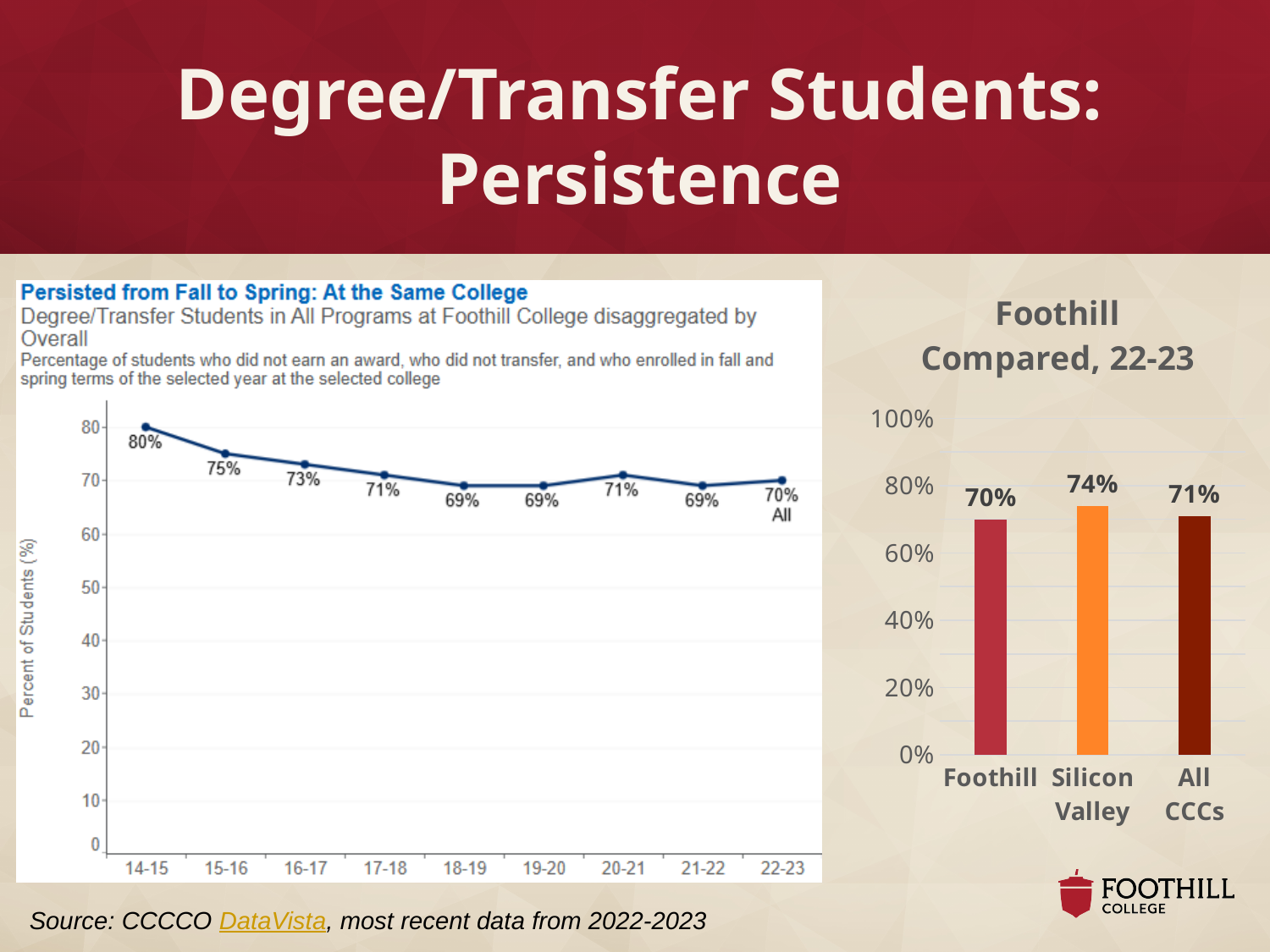
In the 'Foothill Compared, 22-23' chart, what is the value for Silicon Valley? 74% In the line chart 'Persisted from Fall to Spring: At the Same College', do the values generally rise or fall from 14-15 to 18-19? fall In the 'Foothill Compared, 22-23' chart, which category has the lowest value? Foothill What kind of chart is the 'Foothill Compared, 22-23' chart? bar chart In the line chart 'Persisted from Fall to Spring: At the Same College', what is the difference between the values for 14-15 and 22-23? 10 percentage points In the line chart 'Persisted from Fall to Spring: At the Same College', what is the value for 14-15? 80% In the line chart 'Persisted from Fall to Spring: At the Same College', how many years are plotted? 9 What kind of chart is the chart on the left of the slide? line chart In the line chart 'Persisted from Fall to Spring: At the Same College', what is the value for 22-23? 70% In the 'Foothill Compared, 22-23' chart, which is larger, All CCCs or Foothill? All CCCs In the 'Foothill Compared, 22-23' chart, what is the difference between Silicon Valley and Foothill? 4 percentage points In the line chart 'Persisted from Fall to Spring: At the Same College', which year has the highest value? 14-15